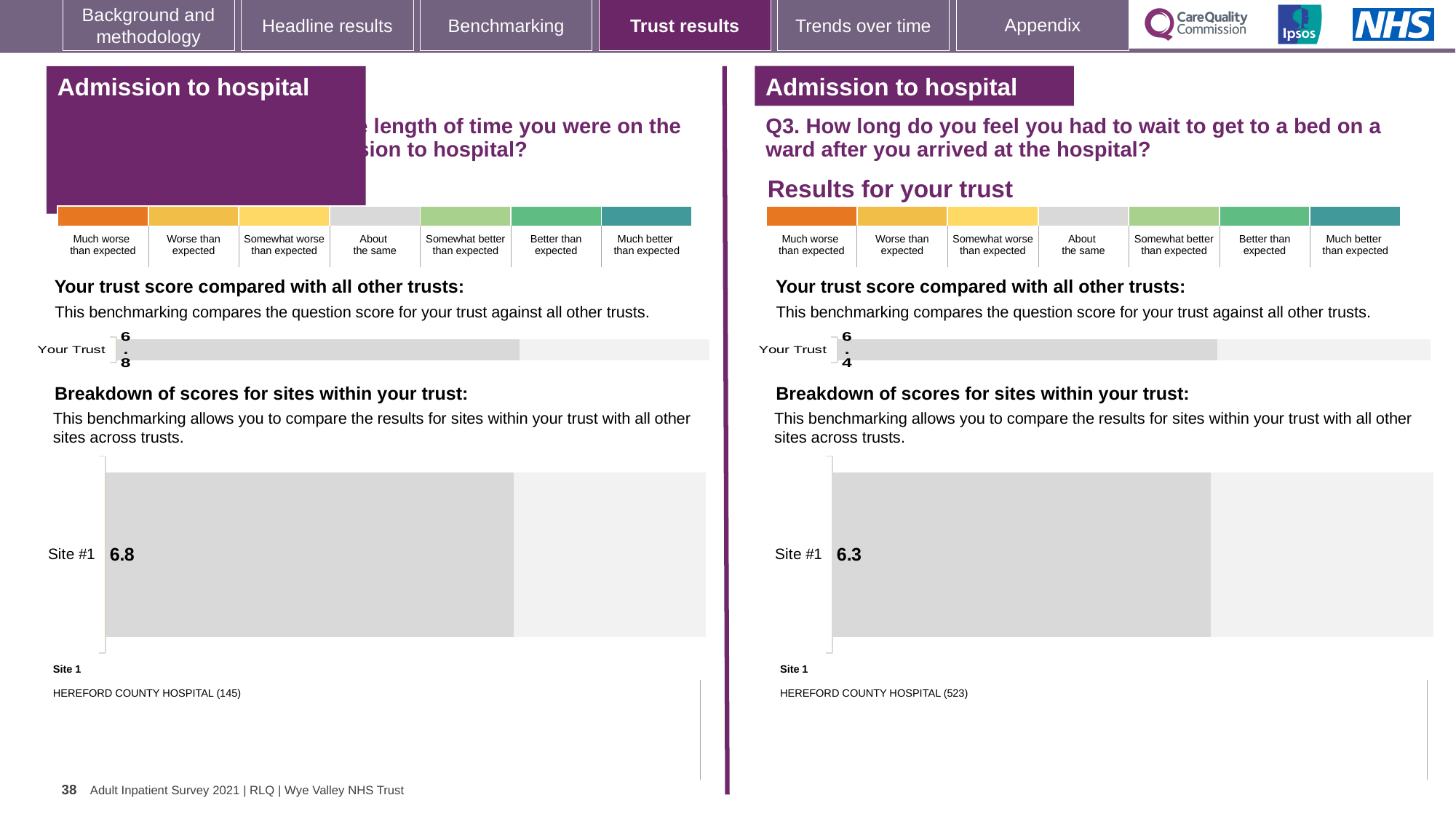
On the left panel, what is the score shown for Site #1 in the breakdown of scores for sites within your trust? 6.8 What is the difference between the Site #1 score on the left panel and the Site #1 score on the right panel (Q3)? 0.5 On the right panel (Q3), which site name is listed as Site 1 below the breakdown chart? HEREFORD COUNTY HOSPITAL (523) What type of chart is used to show the Site #1 score on each panel? Bar chart On the right panel (Q3), what is the 'Your Trust' score in the trust score comparison chart? 6.4 On the right panel (Q3), what is the difference between the 'Your Trust' score and the Site #1 score? 0.1 On the left panel, which site name is listed as Site 1 below the breakdown chart? HEREFORD COUNTY HOSPITAL (145) On the right panel (Q3), what is the score shown for Site #1 in the breakdown of scores for sites within your trust? 6.3 How many sites are shown in the breakdown of scores chart on the right panel (Q3)? 1 Which panel shows the higher Site #1 score, the left panel or the right panel (Q3)? Left panel On the left panel, what is the 'Your Trust' score in the trust score comparison chart? 6.8 On the left panel, is the 'Your Trust' score larger than, smaller than, or equal to the Site #1 score? Equal